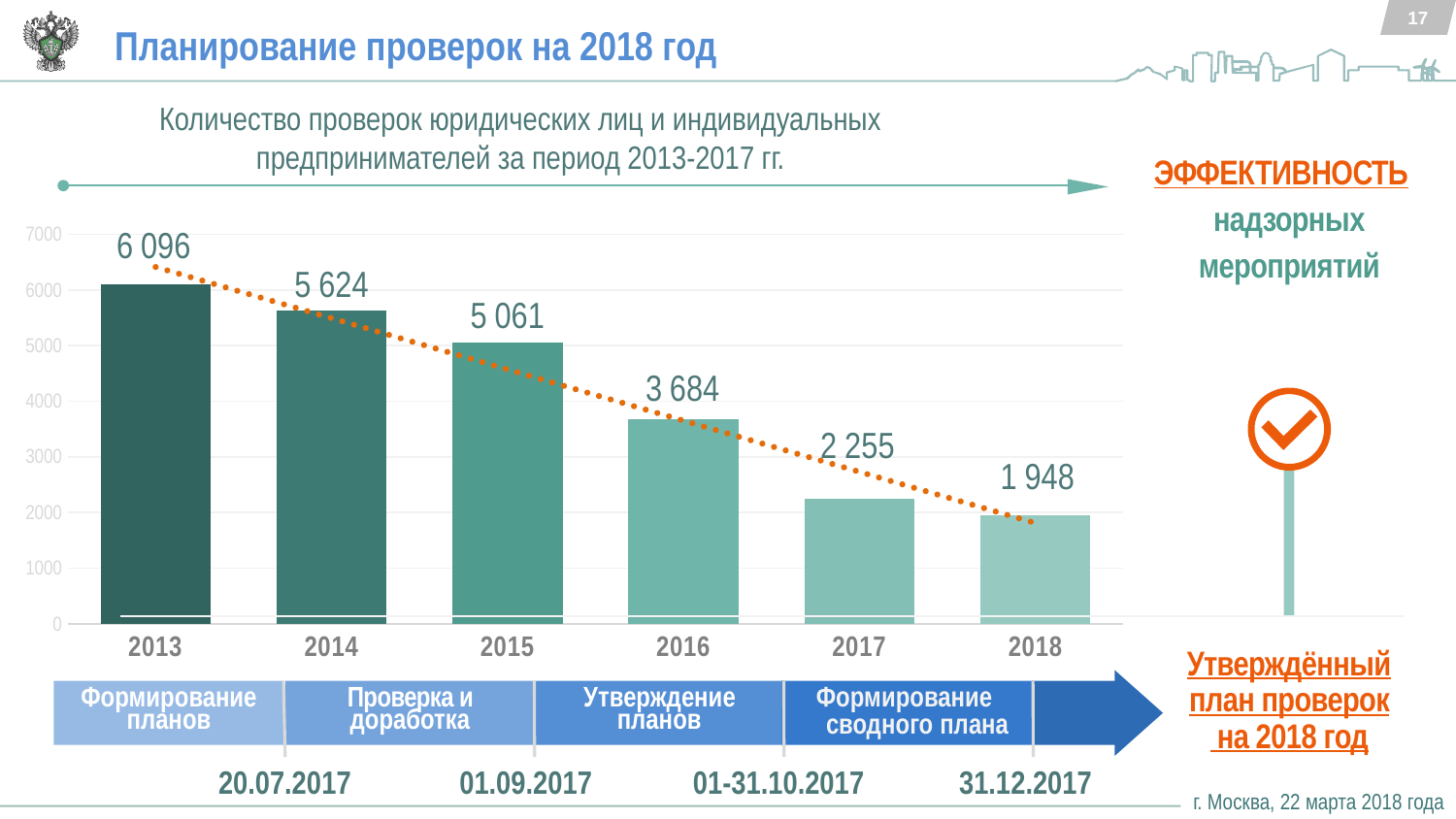
What is the value for 2018? 1 948 What is the difference between the values for 2015 and 2016? 1 377 What kind of chart is shown? bar chart How many years are shown on the x axis? 6 What is the difference between the values for 2013 and 2014? 472 What is the value for 2013? 6 096 What is the value for 2016? 3 684 Which year has the highest value? 2013 Which year has the lowest value? 2018 Which is larger, the value for 2017 or the value for 2018? 2017 Is the value for 2015 greater or less than 5000? greater Do the values rise or fall from 2013 to 2018? fall